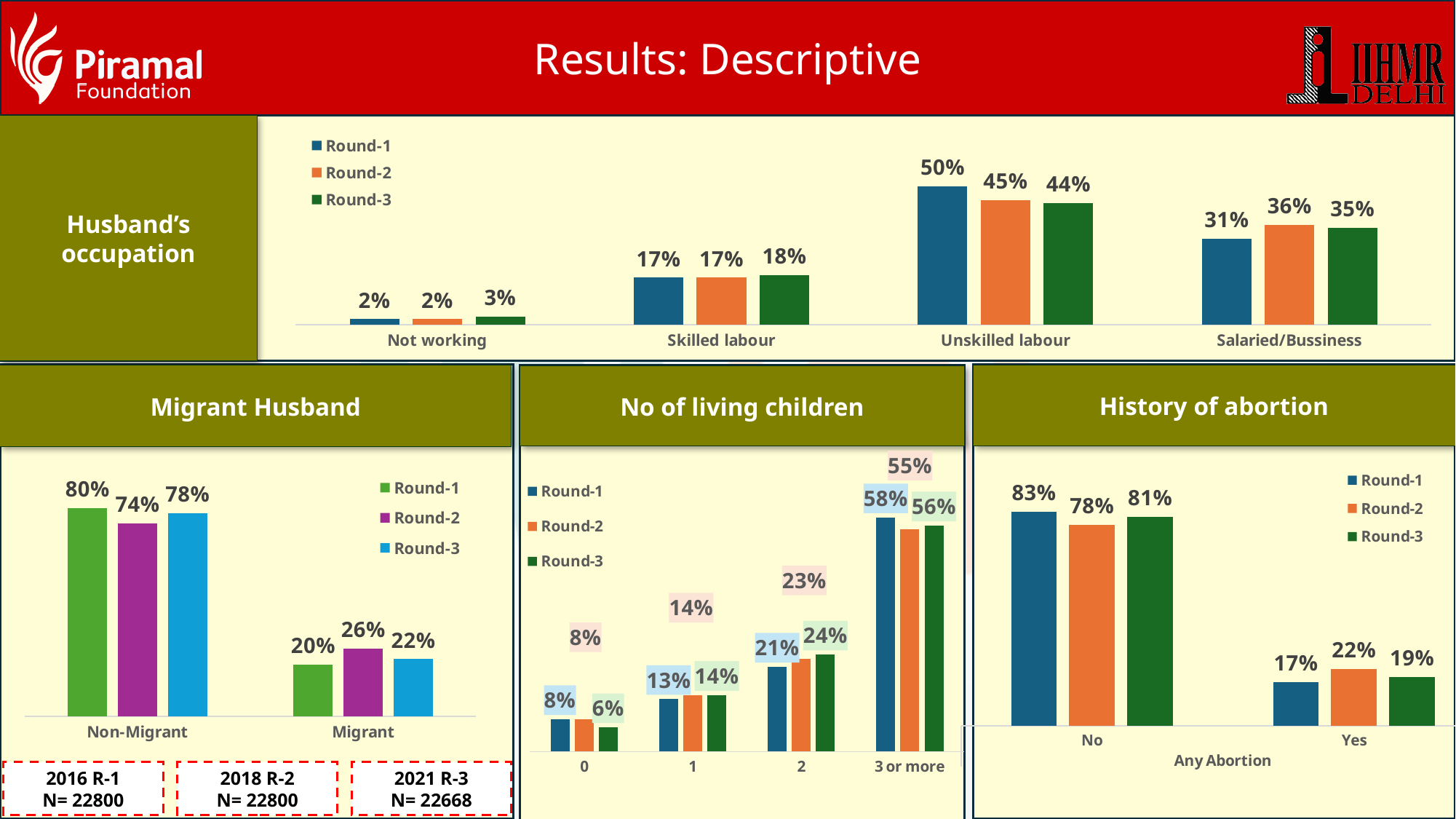
In the No of living children chart, what is the Round-3 value for 0 children? 6% In the Migrant Husband chart, which is larger: the Round-1 value for Non-Migrant or the Round-3 value for Non-Migrant? Round-1 In the Husband's occupation chart, what is the difference between the Round-2 and Round-1 values for Salaried/Bussiness? 5% In the No of living children chart, do the Round-1 values rise or fall as the number of children increases from 0 to 3 or more? rise In the Husband's occupation chart, which occupation category has the lowest values across all rounds? Not working In the Migrant Husband chart, what is the Round-2 value for Migrant? 26% In the No of living children chart, which category has the highest values? 3 or more In the Husband's occupation chart, what is the Round-1 value for Unskilled labour? 50% In the Husband's occupation chart, how many occupation categories are shown on the x axis? 4 In the Migrant Husband chart, how many series does the legend list? 3 In the History of abortion chart, what is the Round-2 value for Yes? 22% What type of chart is the History of abortion chart? bar chart